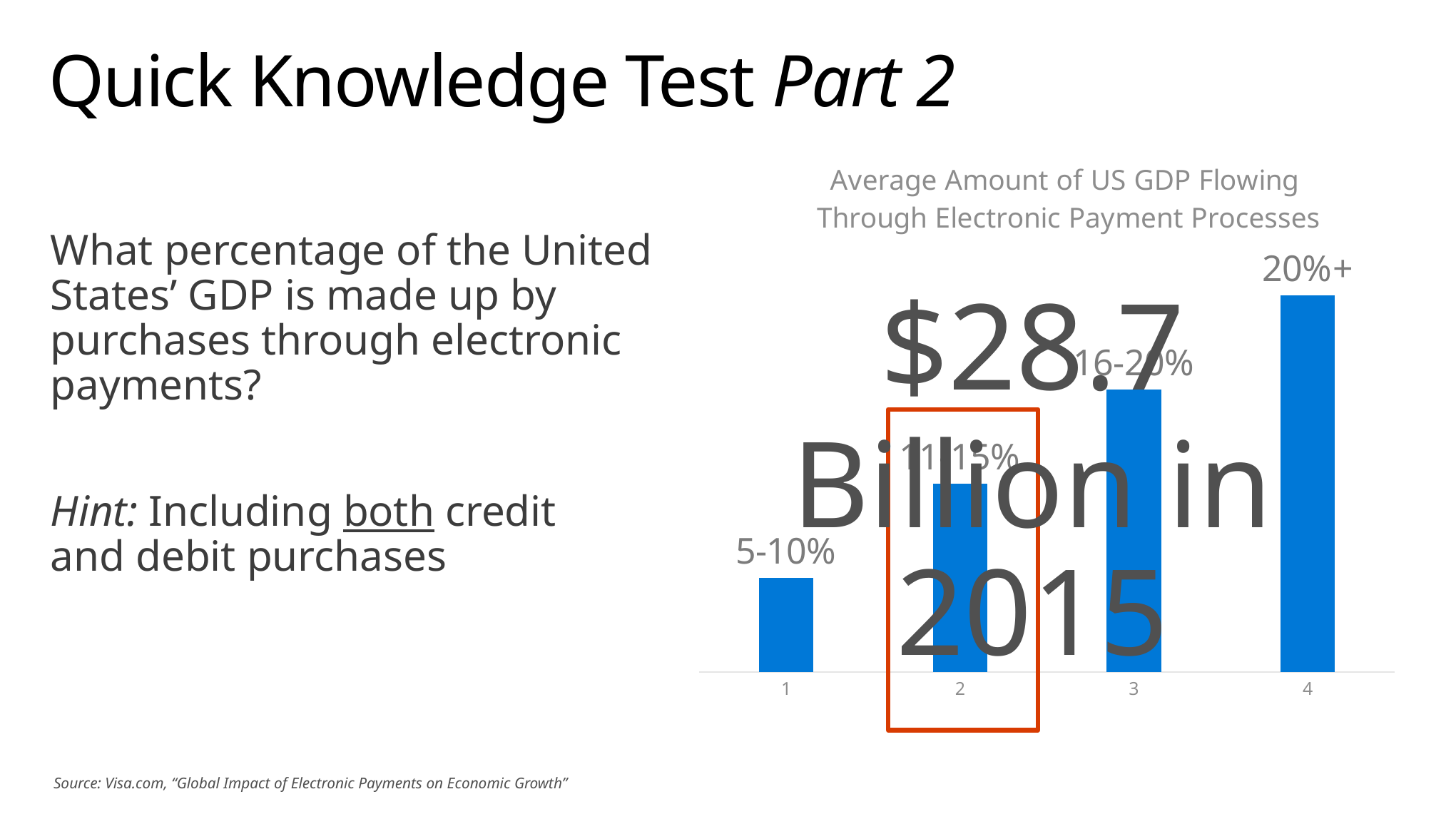
Which bar is outlined by the red box? 2 Which bar is taller, bar 2 or bar 3? 3 What is the data label on bar 1? 5-10% Which bar is the tallest? 4 What is the data label on bar 4? 20%+ How many bars does the chart have? 4 What is the data label on bar 2? 11-15% What kind of chart is shown on the slide? bar chart What is the title of the chart? Average Amount of US GDP Flowing Through Electronic Payment Processes Do the bars rise or fall from category 1 to category 4? rise Which bar is the shortest? 1